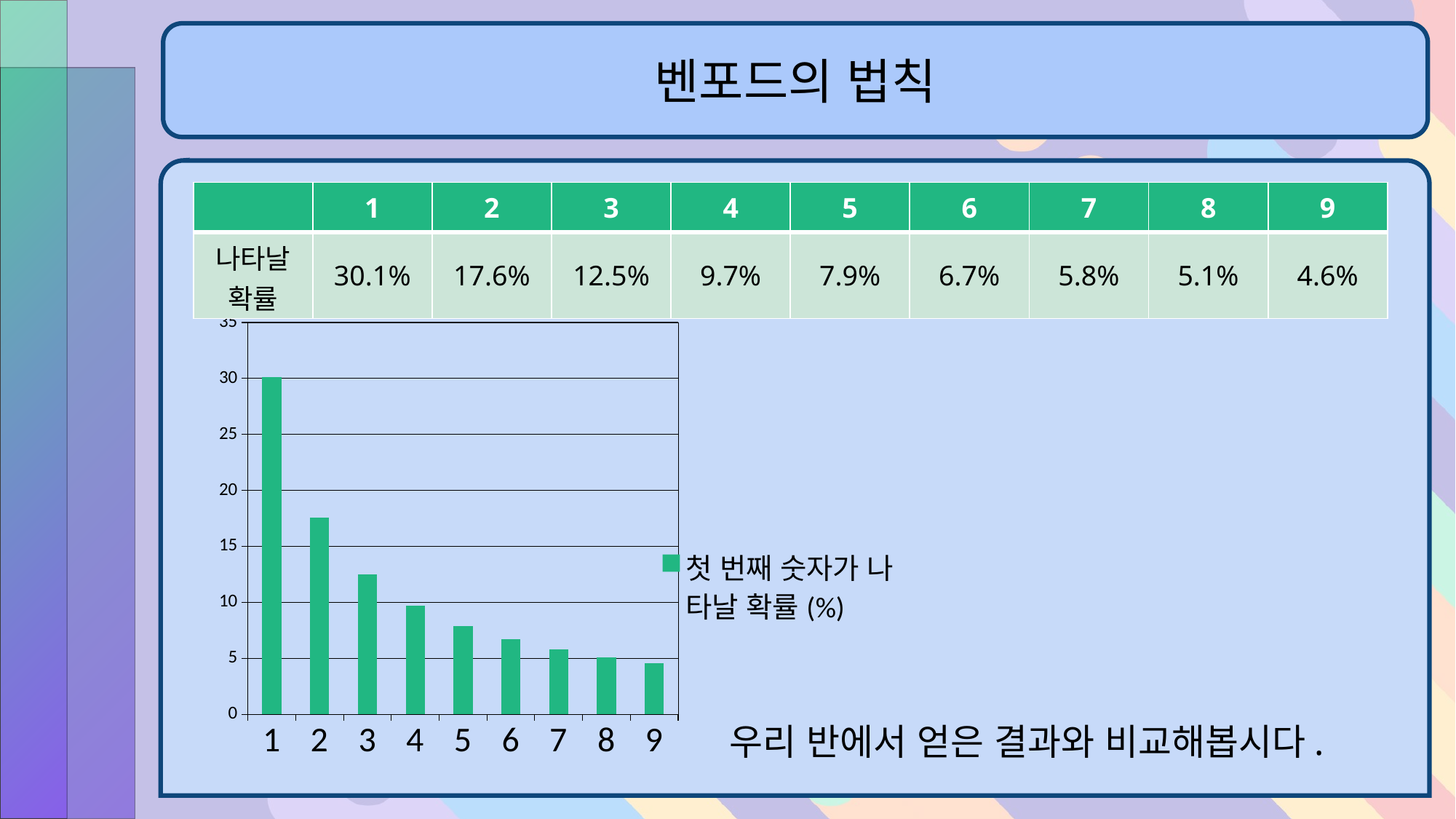
Which category has the lowest bar in the chart? 9 Is the value for category 2 greater or less than 15? greater Is the value for category 1 greater or less than 25? greater How many categories are shown on the x axis of the bar chart? 9 What kind of chart is shown on the slide? bar chart What is the legend entry of the bar chart? 첫 번째 숫자가 나타날 확률 (%) Which category has the highest bar in the chart? 1 Do the bar values rise or fall as you move from 1 to 9 along the x axis? fall Is the value for category 4 greater or less than 10? less According to the table on the slide, what is the probability (나타날 확률) for the digit 5? 7.9% How many series does the legend of the bar chart list? 1 Which is larger, the value for category 3 or the value for category 6? 3